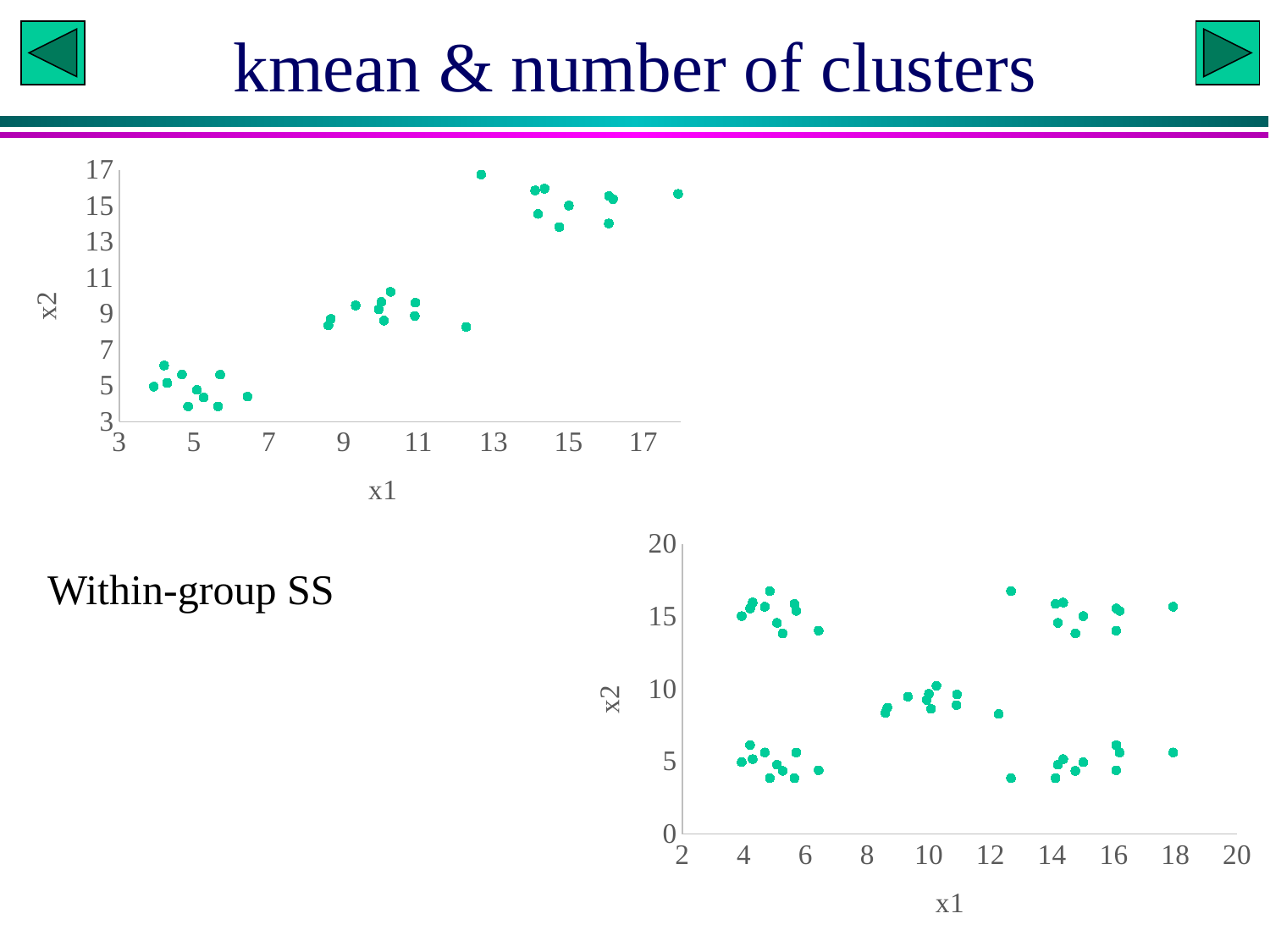
In the top chart, do the x2 values generally rise or fall as x1 increases? rise In the bottom-right chart, is the x1 value of the rightmost point greater or less than 16? greater What is the label of the horizontal axis of the top chart? x1 How many distinct clusters of points are visible in the bottom-right chart? 5 What kind of chart is the top chart on the slide? scatter chart What kind of chart is the bottom-right chart on the slide? scatter chart In the top chart, is the x2 value of the highest point greater or less than 15? greater What is the label of the vertical axis of the bottom-right chart? x2 In the top chart, is the x2 value of the lowest point greater or less than 5? less How many distinct clusters of points are visible in the top chart? 3